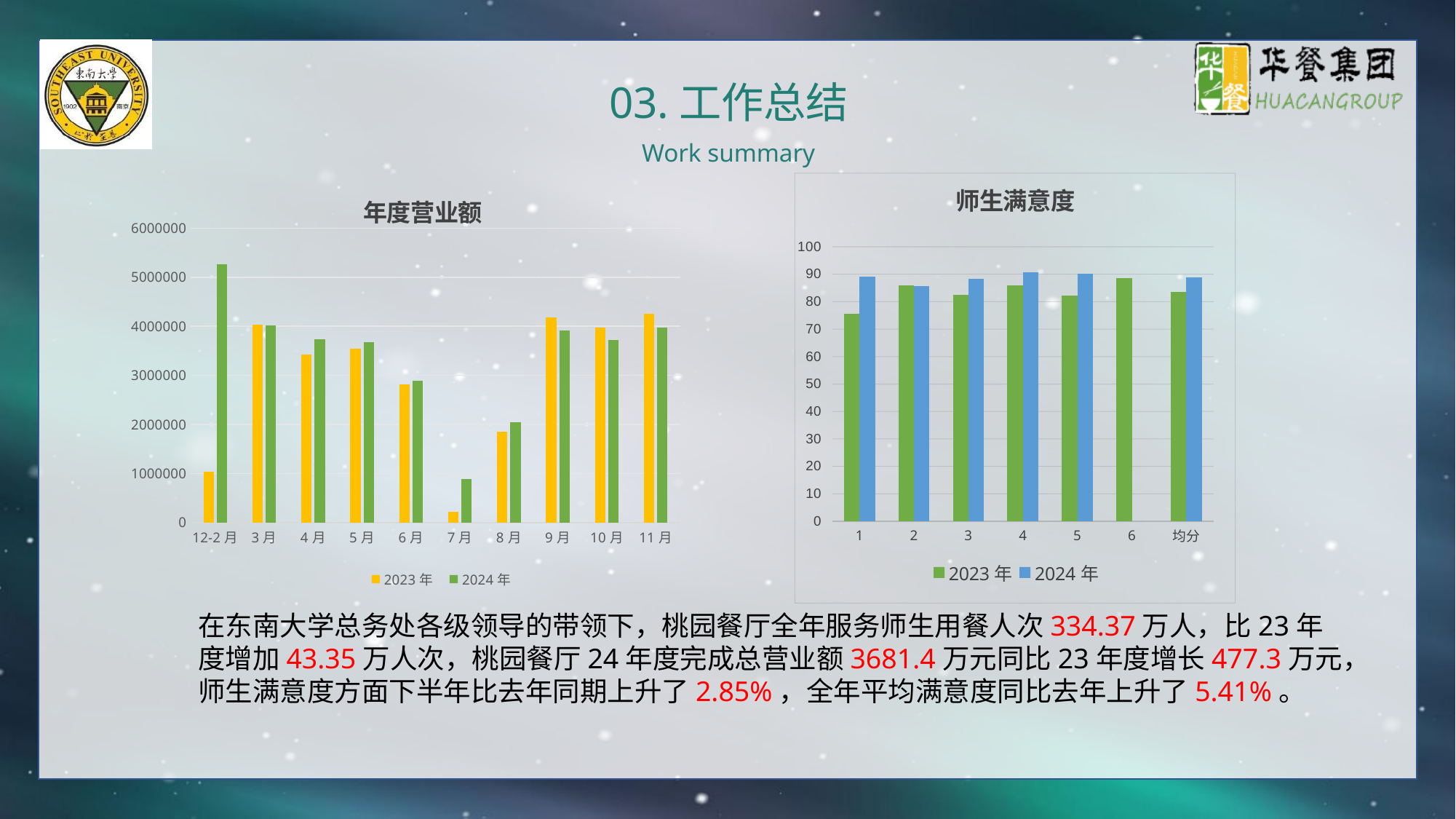
How many categories are shown on the x axis of the 师生满意度 chart? 7 What kind of chart is the 年度营业额 chart? bar chart In the 年度营业额 chart, is the 2023 年 value for 7 月 greater or less than 1000000? less How many categories are shown on the x axis of the 年度营业额 chart? 10 How many series does the legend of the 年度营业额 chart list? 2 In the 年度营业额 chart, which category has the lowest value for 2023 年? 7 月 In the 师生满意度 chart, which is larger for category 3: the 2023 年 value or the 2024 年 value? 2024 年 In the 年度营业额 chart, which is larger for 12-2 月: the 2023 年 value or the 2024 年 value? 2024 年 In the 师生满意度 chart, which category has the lowest value for 2023 年? 1 In the 年度营业额 chart, which category has the highest value for 2024 年? 12-2 月 In the 师生满意度 chart, what colour are the 2024 年 bars? blue In the 年度营业额 chart, is the 2024 年 value for 12-2 月 greater or less than 5000000? greater